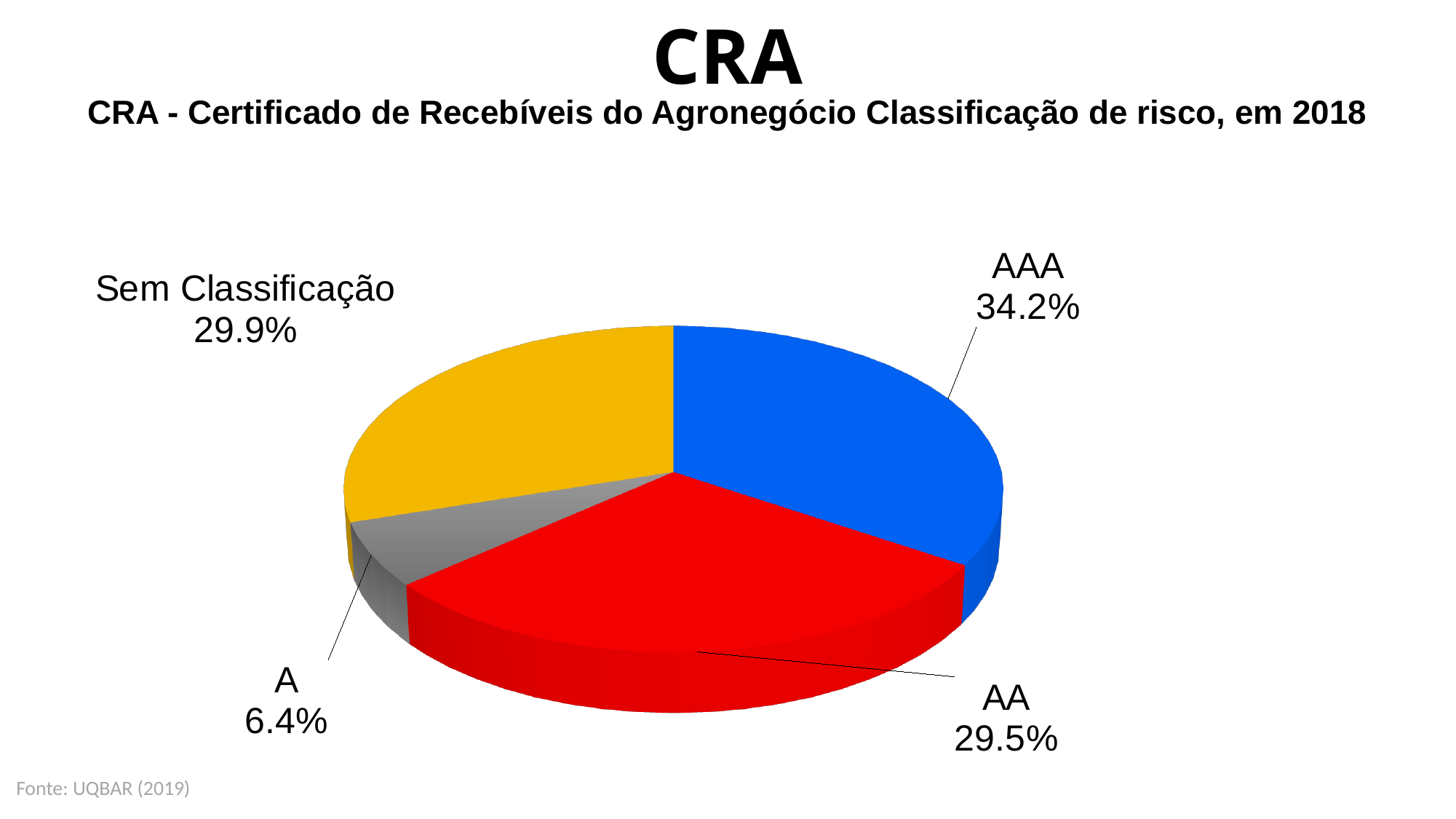
What share of the pie does AAA hold? 34.2% What share of the pie does Sem Classificação hold? 29.9% What is the difference in percentage points between the AAA share and the A share? 27.8 Which category has the largest share of the pie? AAA What is the source cited for the chart? UQBAR (2019) What share of the pie does AA hold? 29.5% How many slices does the pie chart have? 4 What kind of chart is shown on the slide? Pie chart What share of the pie does A hold? 6.4% What colour is the slice for AA? Red Which category has the smallest share of the pie? A Which is larger, the share for AAA or the share for AA? AAA